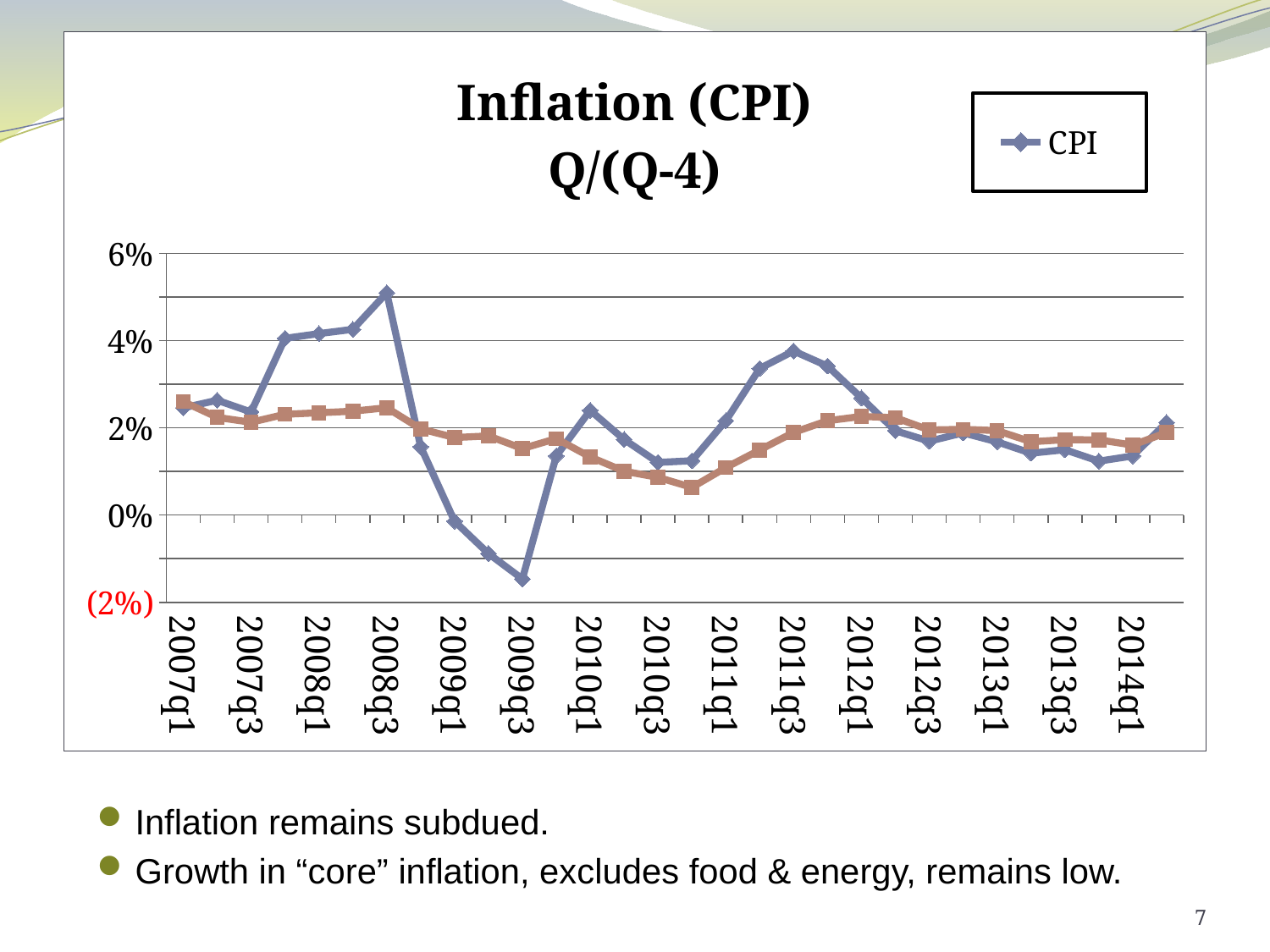
At which x-axis label does the CPI line reach its lowest point? 2009q3 What is the title of the chart? Inflation (CPI) Q/(Q-4) Does the CPI line rise or fall between 2008q3 and 2009q3? fall What kind of chart is shown on the slide? Line chart Is the CPI value at 2011q3 greater or less than 2%? greater Is the CPI value at 2008q3 greater or less than 4%? greater Is the CPI value at 2009q3 greater or less than 0%? less At which x-axis label does the CPI line reach its highest point? 2008q3 How many quarter labels are shown on the x axis? 15 How many series does the legend list? 1 Which is larger, the CPI value at 2008q3 or at 2011q3? 2008q3 What is the name of the series listed in the legend? CPI